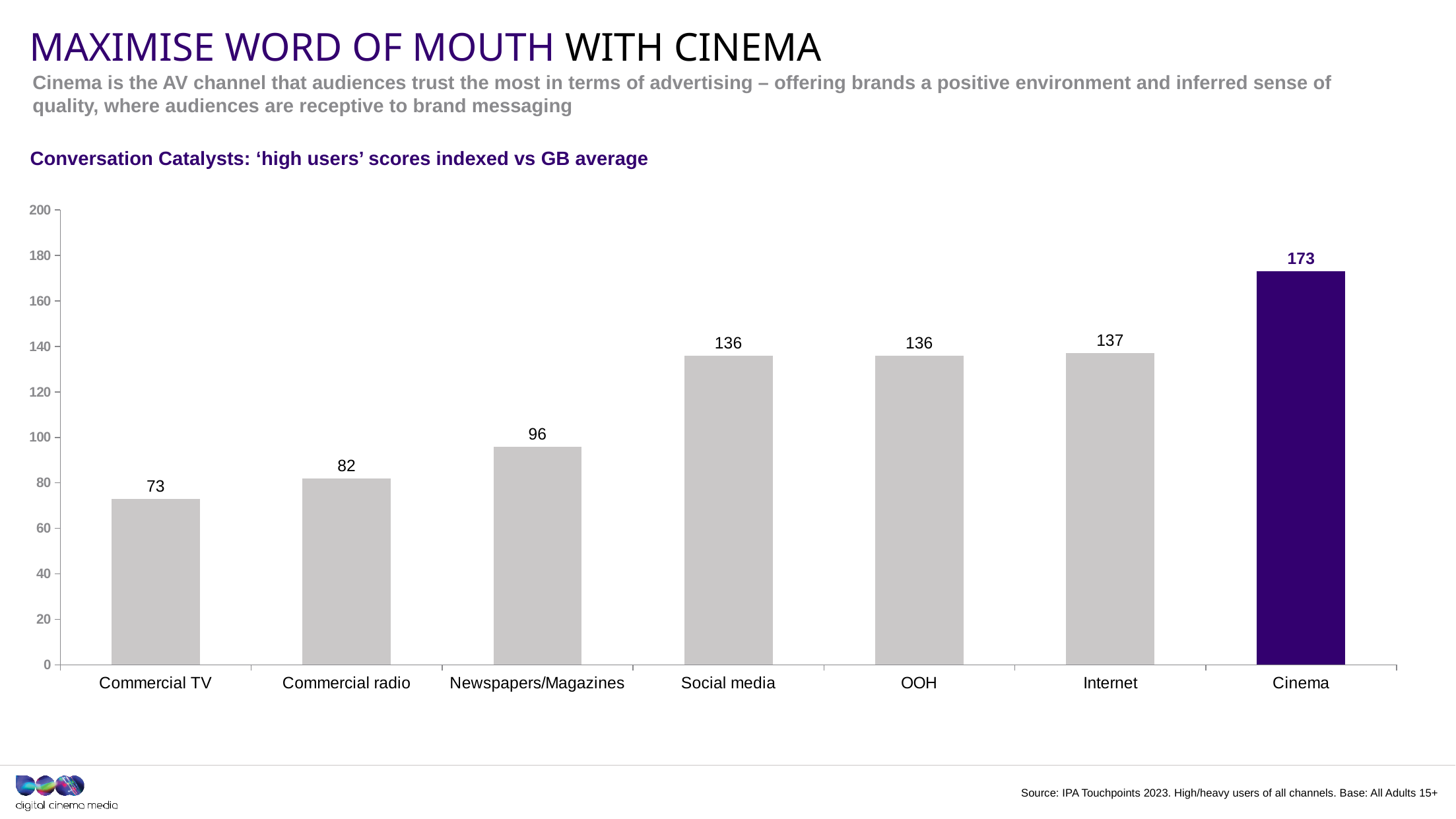
Which category has the highest value? Cinema How many categories are shown on the x axis? 7 What is the value for Commercial TV? 73 What is the value for Cinema? 173 Which category has the lowest value? Commercial TV What kind of chart is shown on the slide? Bar chart What is the difference between the values for Newspapers/Magazines and Commercial radio? 14 What is the value for Internet? 137 What is the difference between the values for Cinema and Commercial TV? 100 Which is larger, the value for Social media or the value for Commercial radio? Social media What is the value for Newspapers/Magazines? 96 What is the title of the chart? Conversation Catalysts: ‘high users’ scores indexed vs GB average